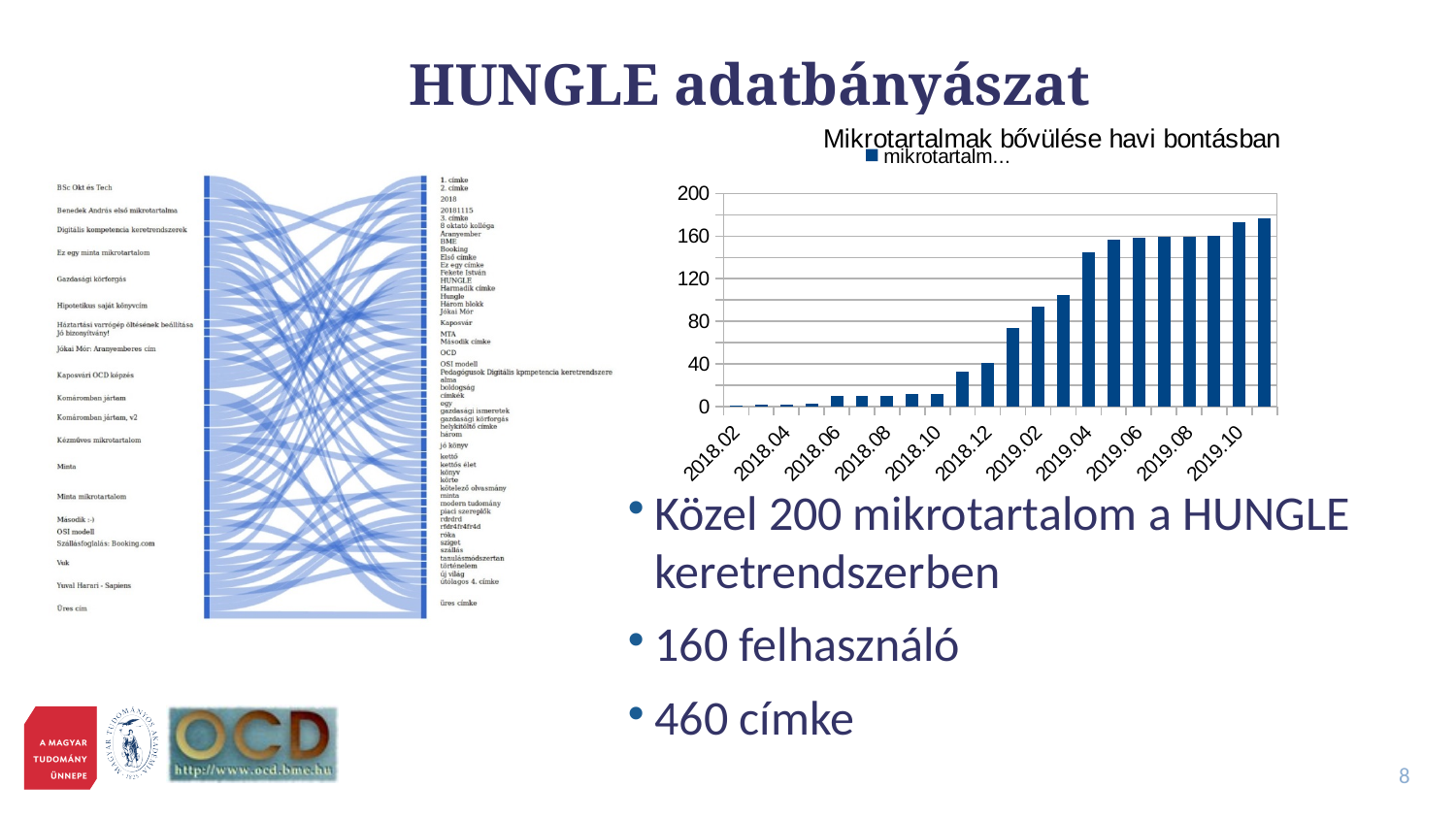
How many month labels are shown on the x axis of the bar chart? 11 Which labeled month on the x axis has the lowest bar in the chart? 2018.02 Do the values in the bar chart generally rise or fall from 2018.02 to 2019.10? rise Is the value for 2018.10 greater or less than 40? less Is the value for 2019.04 greater or less than 120? greater Is the value for 2019.02 greater or less than 80? greater What kind of chart is shown under the title "Mikrotartalmak bővülése havi bontásban"? bar chart How many series does the legend of the bar chart list? 1 What is the title of the bar chart on the slide? Mikrotartalmak bővülése havi bontásban Which has the larger value in the bar chart, 2018.12 or 2019.04? 2019.04